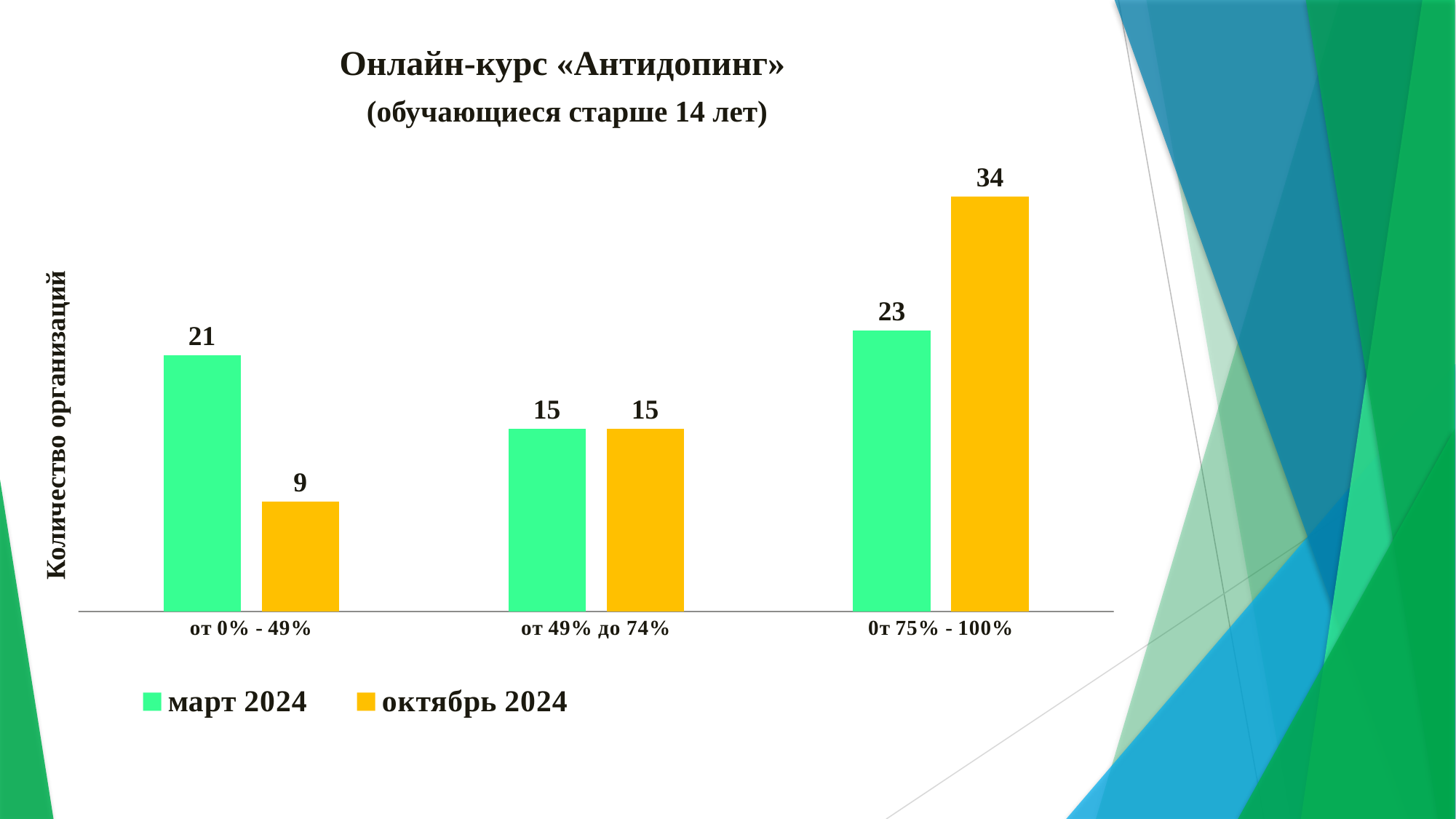
Which category has the lowest value for март 2024? от 49% до 74% How many categories are shown on the x axis? 3 What is the value for октябрь 2024 in the category 0т 75% - 100%? 34 Which is larger in the category от 0% - 49%: март 2024 or октябрь 2024? март 2024 What is the value for октябрь 2024 in the category от 0% - 49%? 9 What kind of chart is shown on the slide? bar chart What is the label of the vertical axis? Количество организаций What is the value for март 2024 in the category от 0% - 49%? 21 What is the value for март 2024 in the category от 49% до 74%? 15 How many series does the legend list? 2 What is the difference between октябрь 2024 and март 2024 in the category 0т 75% - 100%? 11 Which category has the highest value for октябрь 2024? 0т 75% - 100%